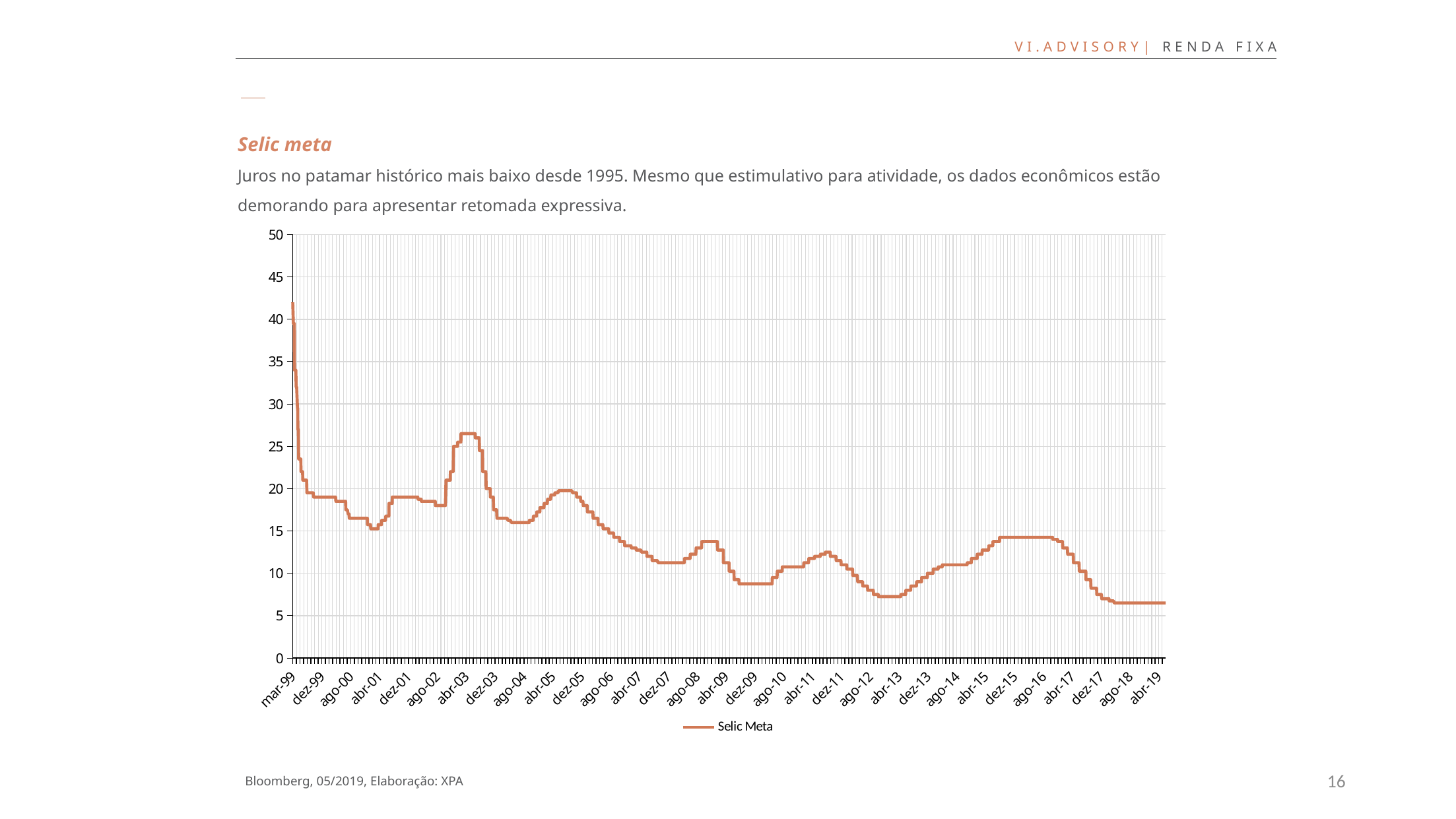
What kind of chart is shown on the slide? line chart Which is larger, the value for abr-03 or the value for dez-07? abr-03 Is the value for mar-99 greater or less than 40? greater Is the value for abr-03 greater or less than 25? greater Is the value for abr-19 greater or less than 10? less Overall, does the Selic Meta rise or fall from mar-99 to abr-19? fall Which period has the highest Selic Meta value on the chart? mar-99 What is the title of the chart? Selic meta How many series does the legend list? 1 What is the name of the series shown in the legend? Selic Meta